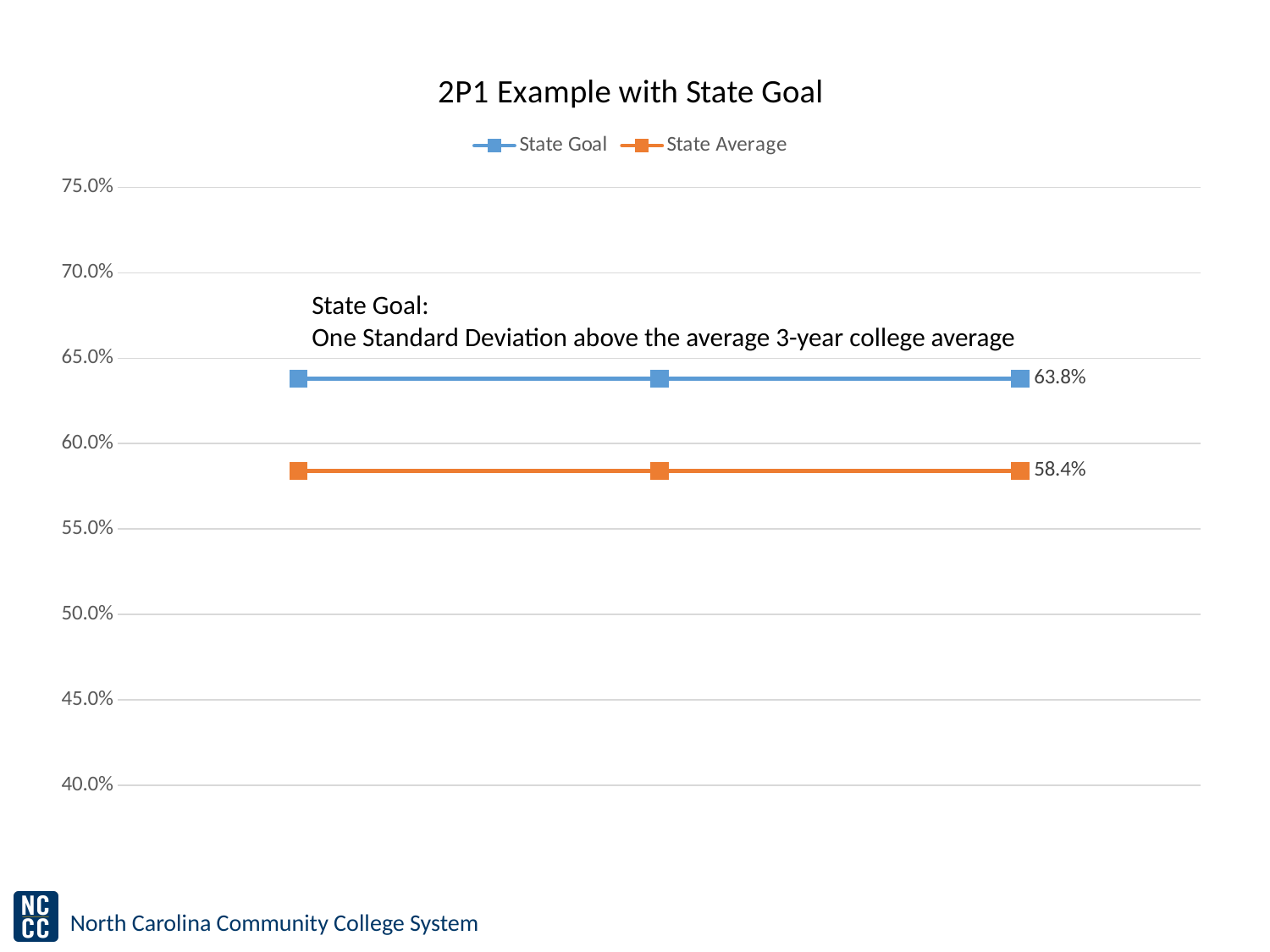
What colour is the State Average line? Orange Do the values of the State Goal line rise, fall, or stay flat along the x axis? Stay flat What kind of chart is shown on the slide? Line chart Is the value for State Average greater or less than 60.0%? less Is the value for State Goal greater or less than 65.0%? less What is the difference between the State Goal (63.8%) and the State Average (58.4%)? 5.4 percentage points Which series has the higher value, State Goal or State Average? State Goal What value is labelled for the State Goal line? 63.8% How many data points are plotted on the State Average line? 3 How many series does the legend list? 2 What is the title of the chart? 2P1 Example with State Goal What value is labelled for the State Average line? 58.4%